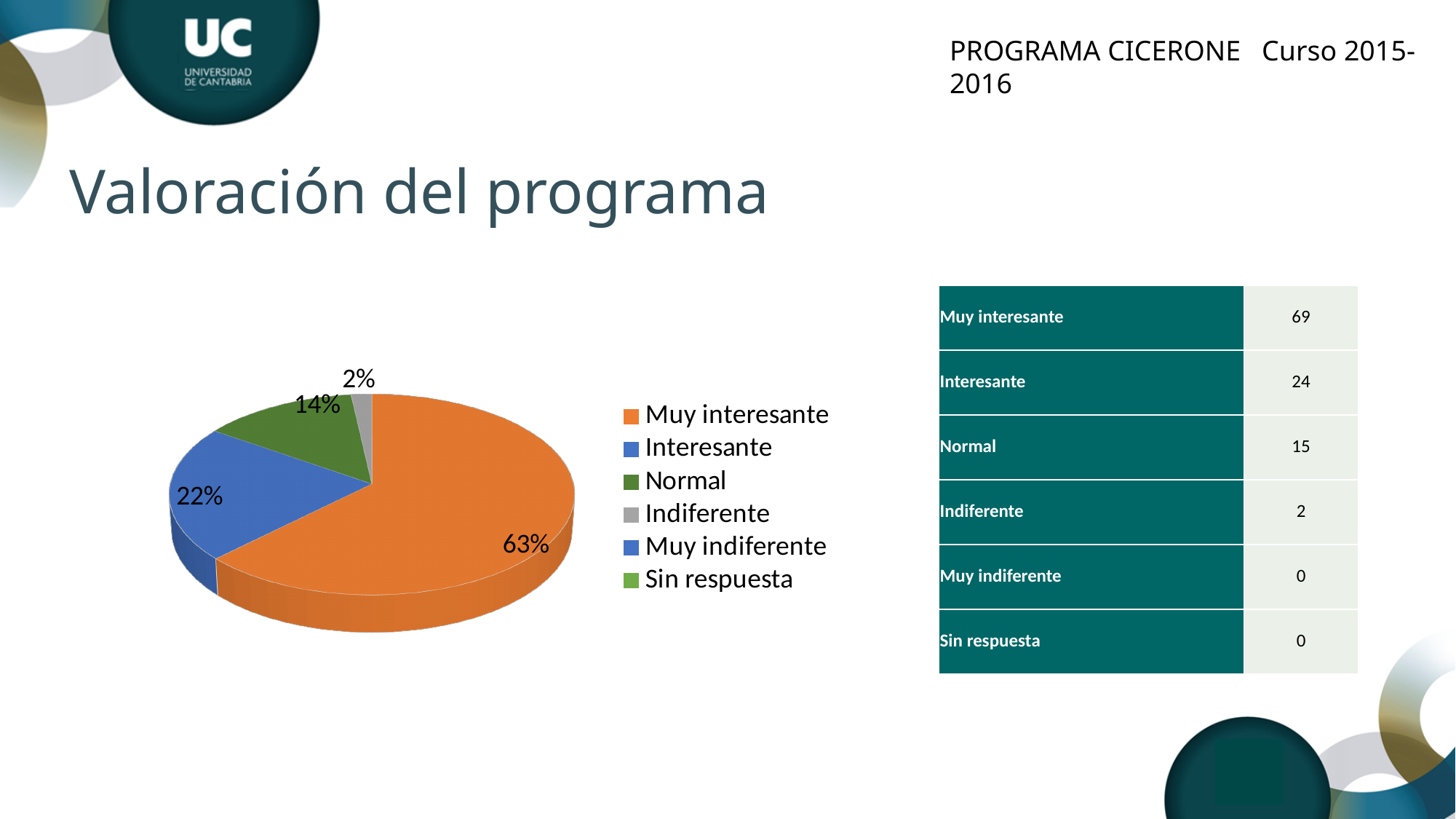
What percentage of the pie does the Muy interesante slice represent? 63% Which of the labelled slices is the smallest? Indiferente What kind of chart is shown on the slide? pie chart What colour is the Muy interesante slice in the pie chart? orange Which slice is larger, Normal or Interesante? Interesante Which category has the largest slice of the pie? Muy interesante How many entries does the legend of the pie chart list? 6 What percentage of the pie does the Normal slice represent? 14% What percentage of the pie does the Interesante slice represent? 22% What is the title of the slide containing the pie chart? Valoración del programa What is the difference in percentage points between the Muy interesante and Interesante slices? 41